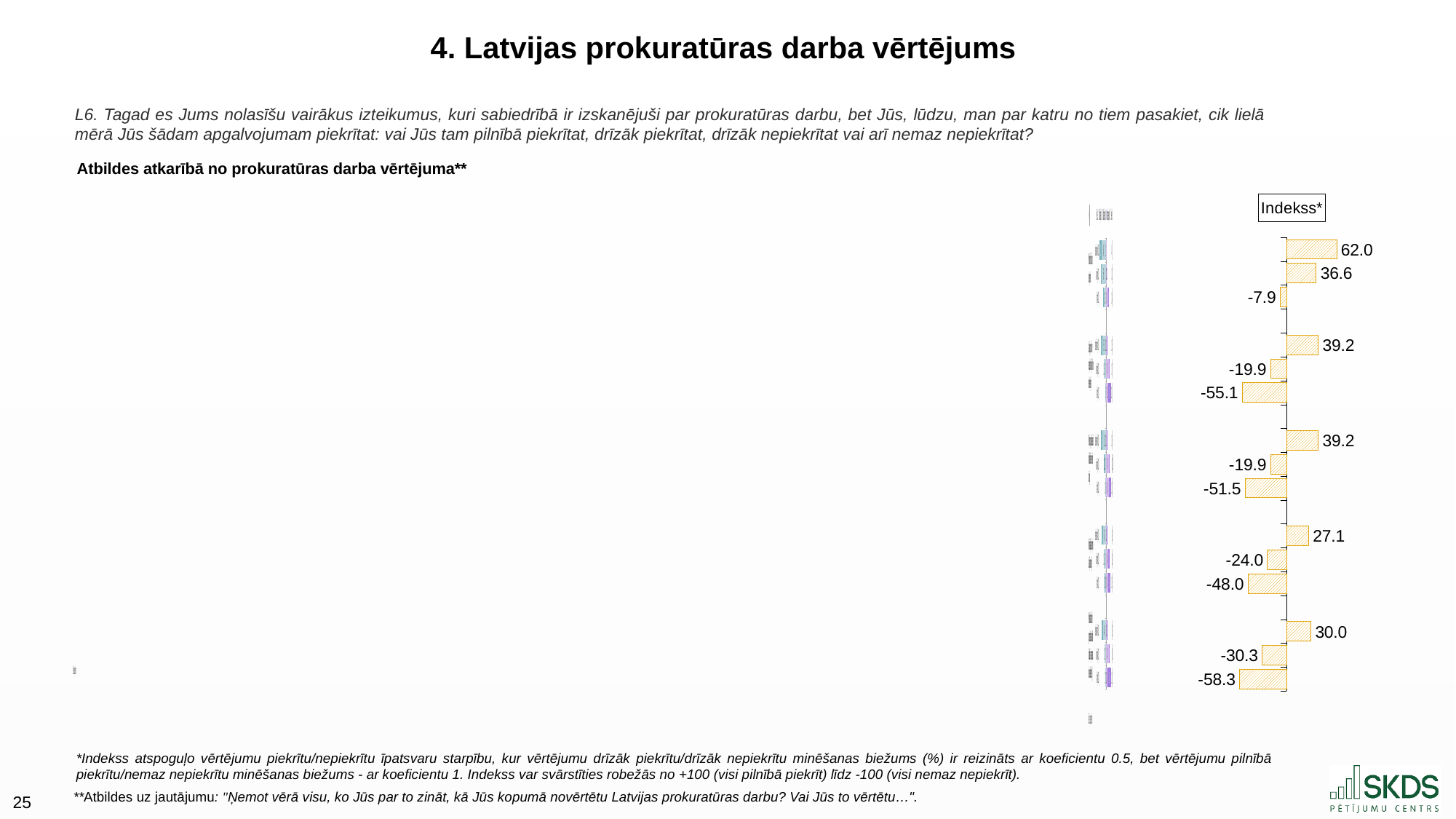
What is the value of the second bar from the top in the Indekss* chart? 36.6 What is the value of the topmost bar in the Indekss* chart? 62.0 What is the value of the third bar from the top in the Indekss* chart? -7.9 What is the highest value shown in the Indekss* chart? 62.0 What kind of chart is the Indekss* chart on the right of the slide? bar chart How many bars are plotted in the Indekss* chart? 15 In the Indekss* chart, what is the difference between the highest value (62.0) and the lowest value (-58.3)? 120.3 How many bars in the Indekss* chart have negative values? 9 In the Indekss* chart, what is the difference between the topmost bar (62.0) and the second bar (36.6)? 25.4 In the Indekss* chart, which is larger: the topmost bar or the second bar from the top? the topmost bar What is the value of the bottom bar in the Indekss* chart? -58.3 What is the lowest value shown in the Indekss* chart? -58.3